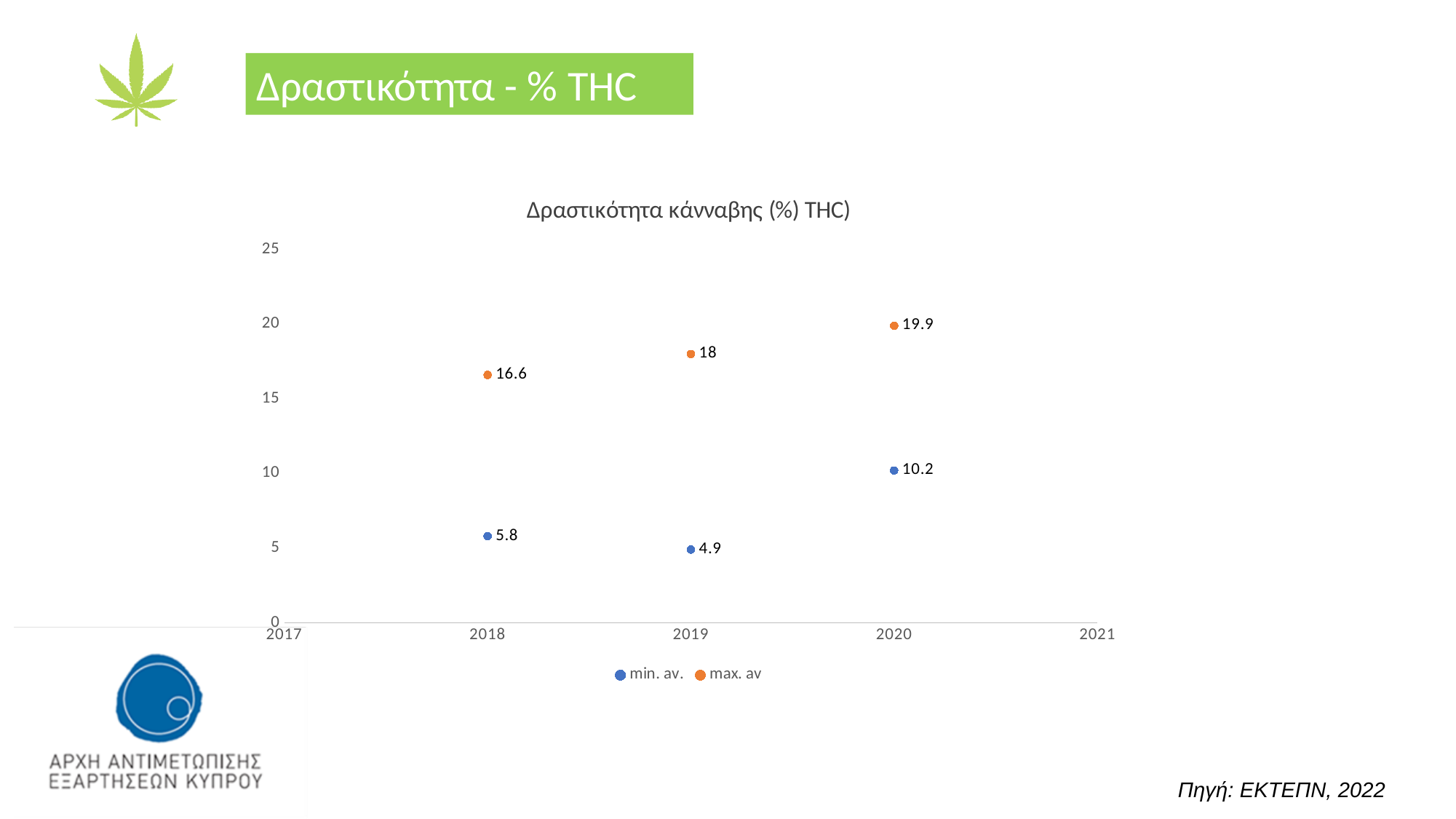
Which is larger, the min. av. value for 2018 or for 2020? 2020 What is the min. av. value for 2019? 4.9 What is the title of the chart? Δραστικότητα κάνναβης (%) THC) What is the difference between the max. av and min. av. values in 2019? 13.1 What is the min. av. value for 2020? 10.2 Does the max. av series rise or fall from 2018 to 2020? rise Is the max. av value for 2019 greater or less than 15? greater Which year has the highest max. av value? 2020 What is the max. av value for 2018? 16.6 How many series does the legend list? 2 What is the max. av value for 2020? 19.9 Which year has the lowest min. av. value? 2019